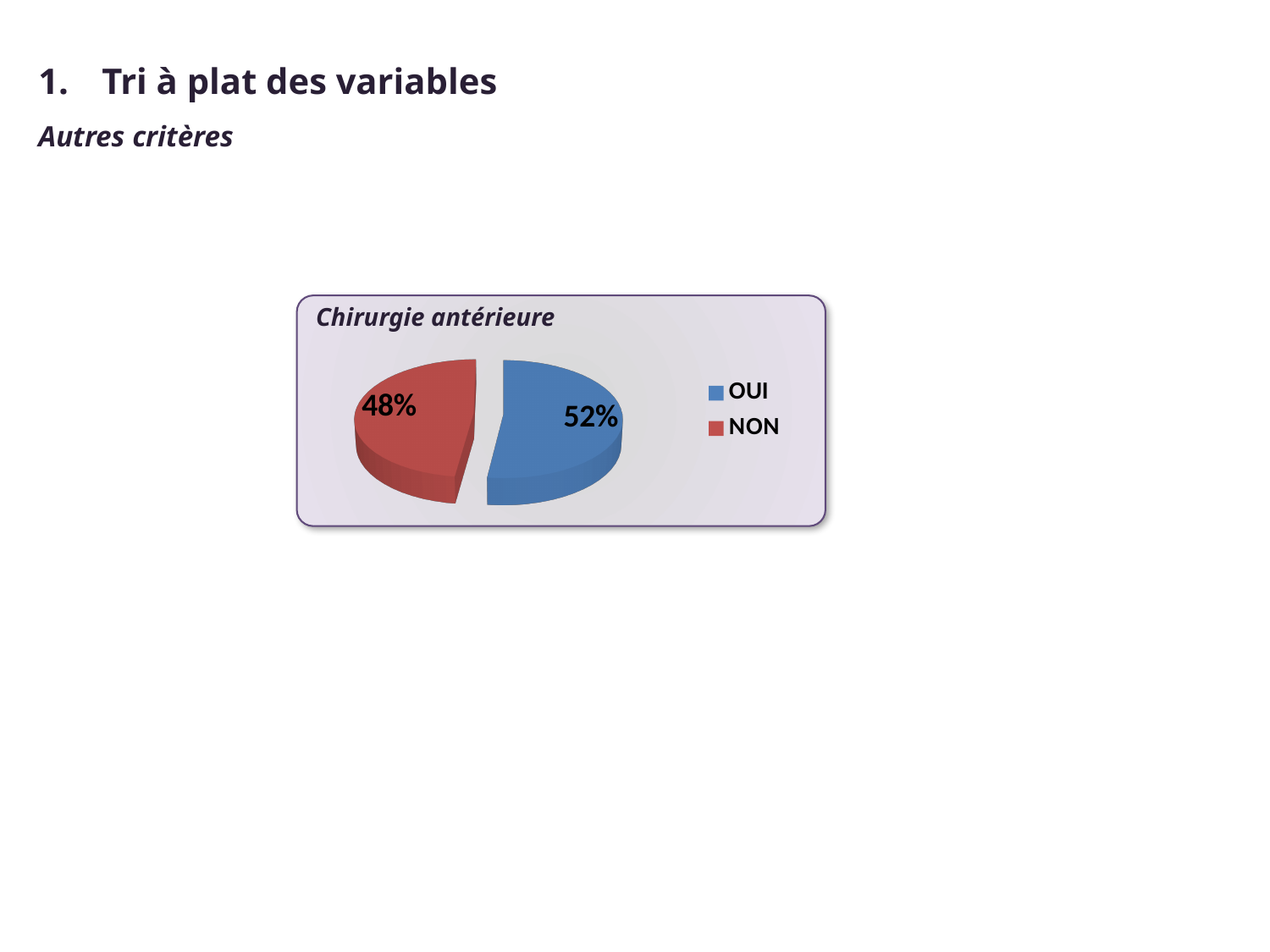
What is the title of the chart? Chirurgie antérieure How many entries does the legend list? 2 How many slices does the pie chart have? 2 Which slice is larger, OUI or NON? OUI What is the difference in percentage points between the OUI and NON slices? 4 Which category has the largest share of the pie? OUI What kind of chart is shown on the slide? Pie chart What percentage of the pie does the NON slice represent? 48% What colour is the NON slice? Red What percentage of the pie does the OUI slice represent? 52% Which category has the smallest share of the pie? NON